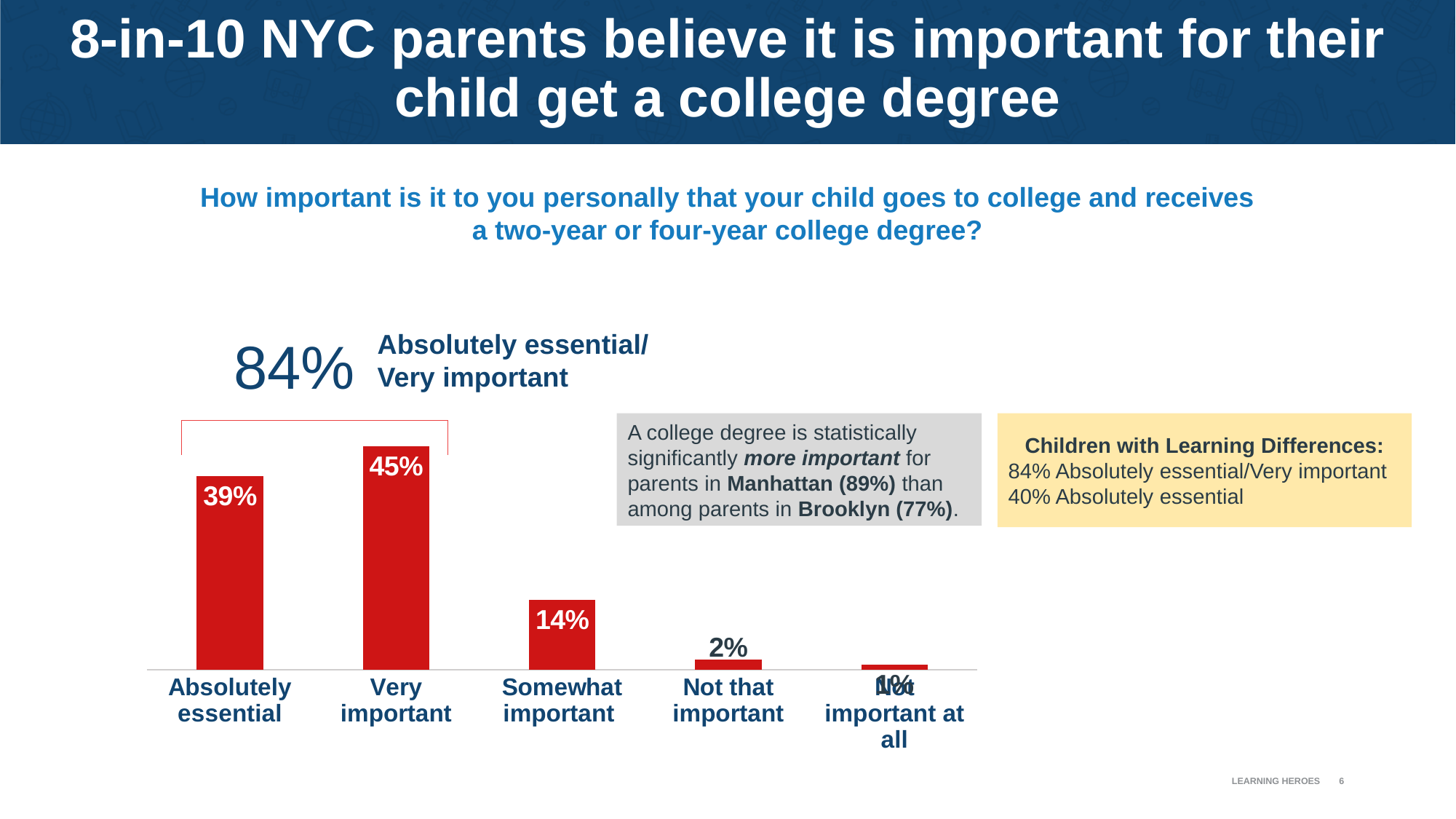
What percentage of parents chose "Absolutely essential"? 39% What is the difference between the "Very important" and "Absolutely essential" percentages? 6% How many response categories are shown on the x axis of the chart? 5 Which is larger: the percentage for "Somewhat important" or for "Not that important"? Somewhat important What is the value shown for "Somewhat important"? 14% What type of chart is used on this slide? Bar chart What colour are the bars in the chart? Red What is the value shown for "Not that important"? 2% Which response category has the highest percentage? Very important What combined percentage is shown for "Absolutely essential/Very important" above the chart? 84% What percentage of NYC parents said it is "Very important" that their child gets a college degree? 45% Which response category has the lowest percentage? Not important at all